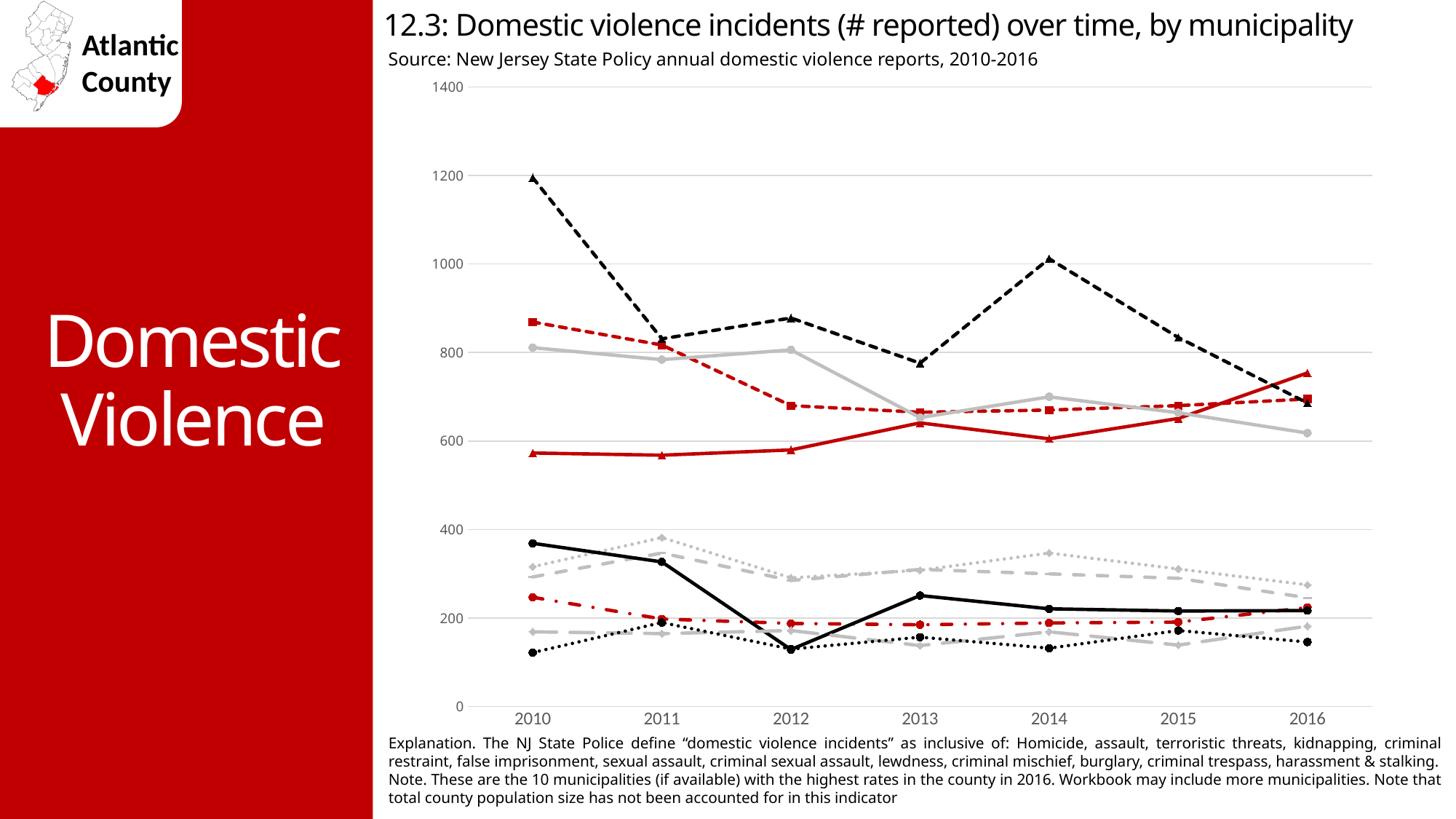
Does the black dashed line with triangle markers rise or fall from 2010 to 2011? fall Is the 2016 value of the solid red line with triangle markers greater or less than 600? greater How many years are shown along the x axis of the chart? 7 Is the 2014 value of the black dashed line with triangle markers greater or less than 800? greater Is the 2010 value of the red dashed line with square markers greater or less than 800? greater What is the highest value shown on the chart's y axis? 1400 What kind of chart is shown on the slide? line chart In which year does the black dashed line with triangle markers reach its highest value? 2010 What is the title of the chart on the slide? 12.3: Domestic violence incidents (# reported) over time, by municipality In 2010, which is higher: the black dashed line with triangle markers or the red dashed line with square markers? the black dashed line with triangle markers